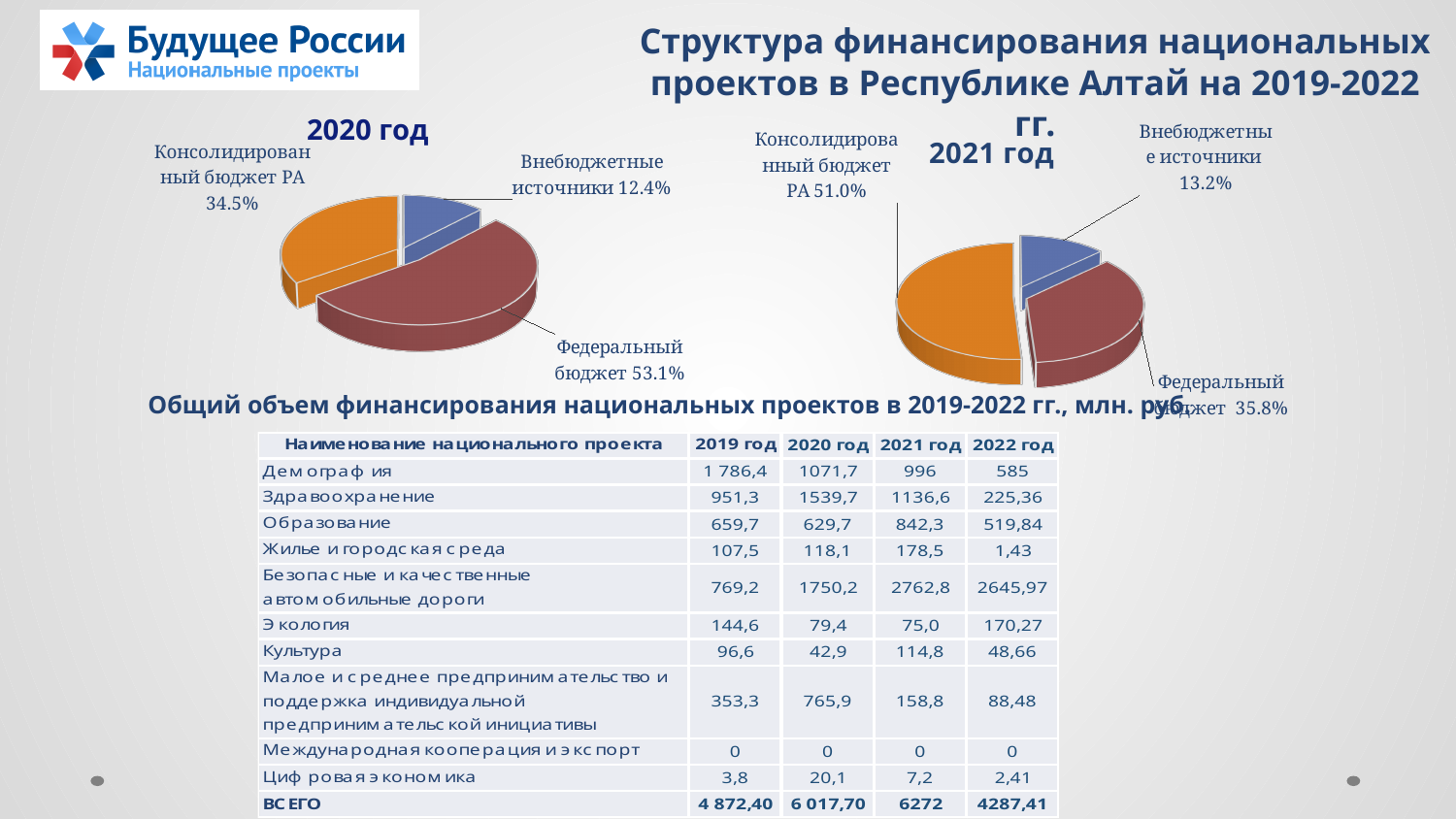
In the 2021 год pie chart, what share do Внебюджетные источники have? 13.2% In the 2020 год pie chart, what share does Консолидированный бюджет РА have? 34.5% In the 2021 год pie chart, which is larger: Консолидированный бюджет РА or Федеральный бюджет? Консолидированный бюджет РА In the 2021 год pie chart, what share does Федеральный бюджет have? 35.8% In the 2021 год pie chart, what share does Консолидированный бюджет РА have? 51.0% What is the difference between the Федеральный бюджет share in the 2020 год chart and in the 2021 год chart? 17.3% What type of chart is used for 2021 год? Pie chart How many slices does the 2020 год pie chart have? 3 In the 2021 год pie chart, which source has the smallest share? Внебюджетные источники In the 2020 год pie chart, what share do Внебюджетные источники have? 12.4% In the 2020 год pie chart, what share does Федеральный бюджет have? 53.1% In the 2020 год pie chart, which source has the largest share? Федеральный бюджет